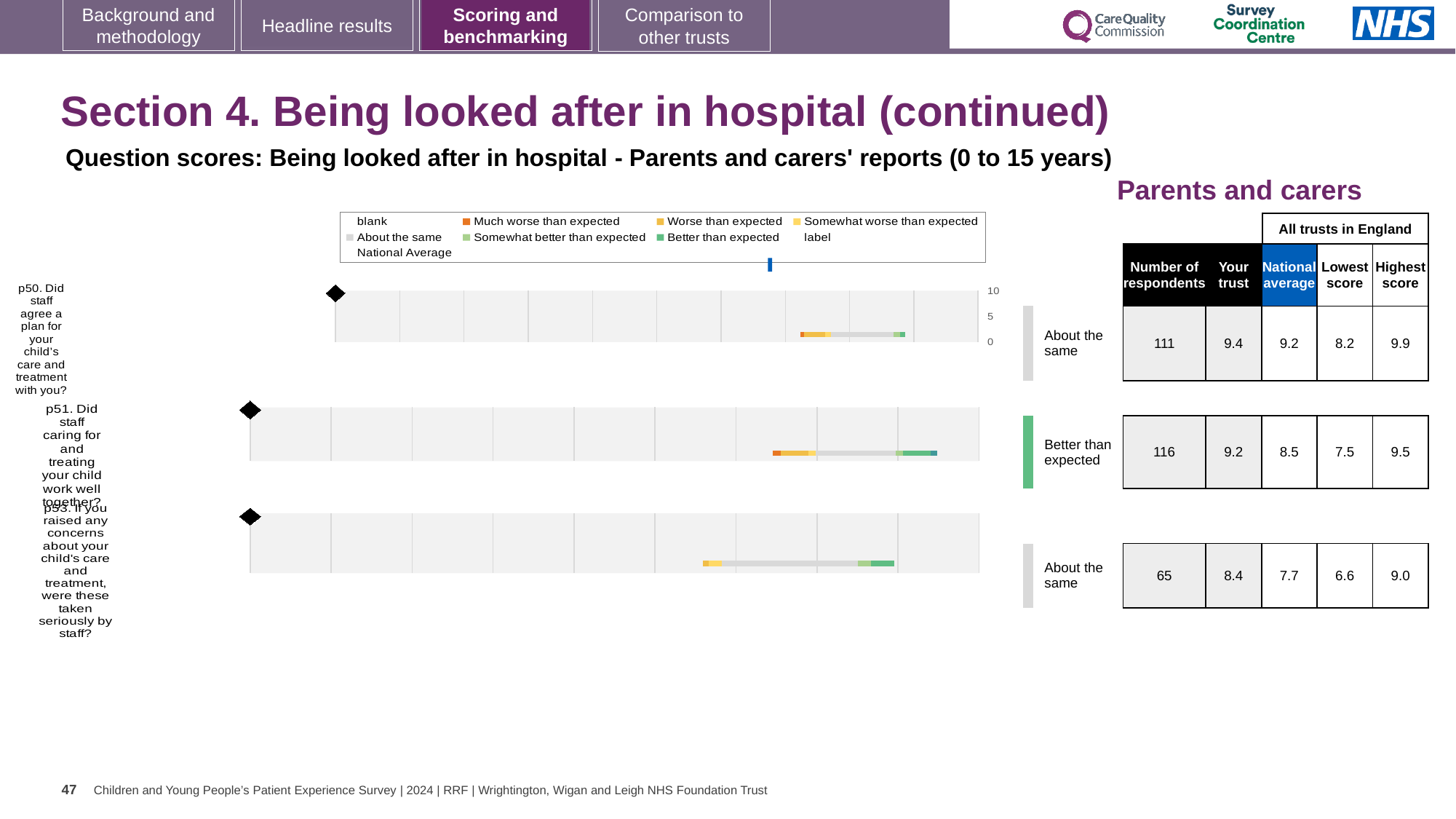
How many questions are plotted on this slide? 3 What is the national average score for question p53 (If you raised any concerns about your child's care and treatment, were these taken seriously by staff?)? 7.7 How many respondents answered question p50 (Did staff agree a plan for your child's care and treatment with you?)? 111 What is the highest score among all trusts in England for question p50? 9.9 What is the 'Your trust' score for question p51 (Did staff caring for and treating your child work well together?)? 9.2 Which question has the highest 'Your trust' score on this slide? p50 What benchmark category is shown for question p51? Better than expected For question p51, which is larger: the 'Your trust' score or the national average? Your trust Which question has the fewest respondents on this slide? p53 For question p53, what is the difference between the 'Your trust' score and the national average? 0.7 What is the lowest score among all trusts in England for question p51? 7.5 What kind of chart is used to show the question scores on this slide? Bar chart